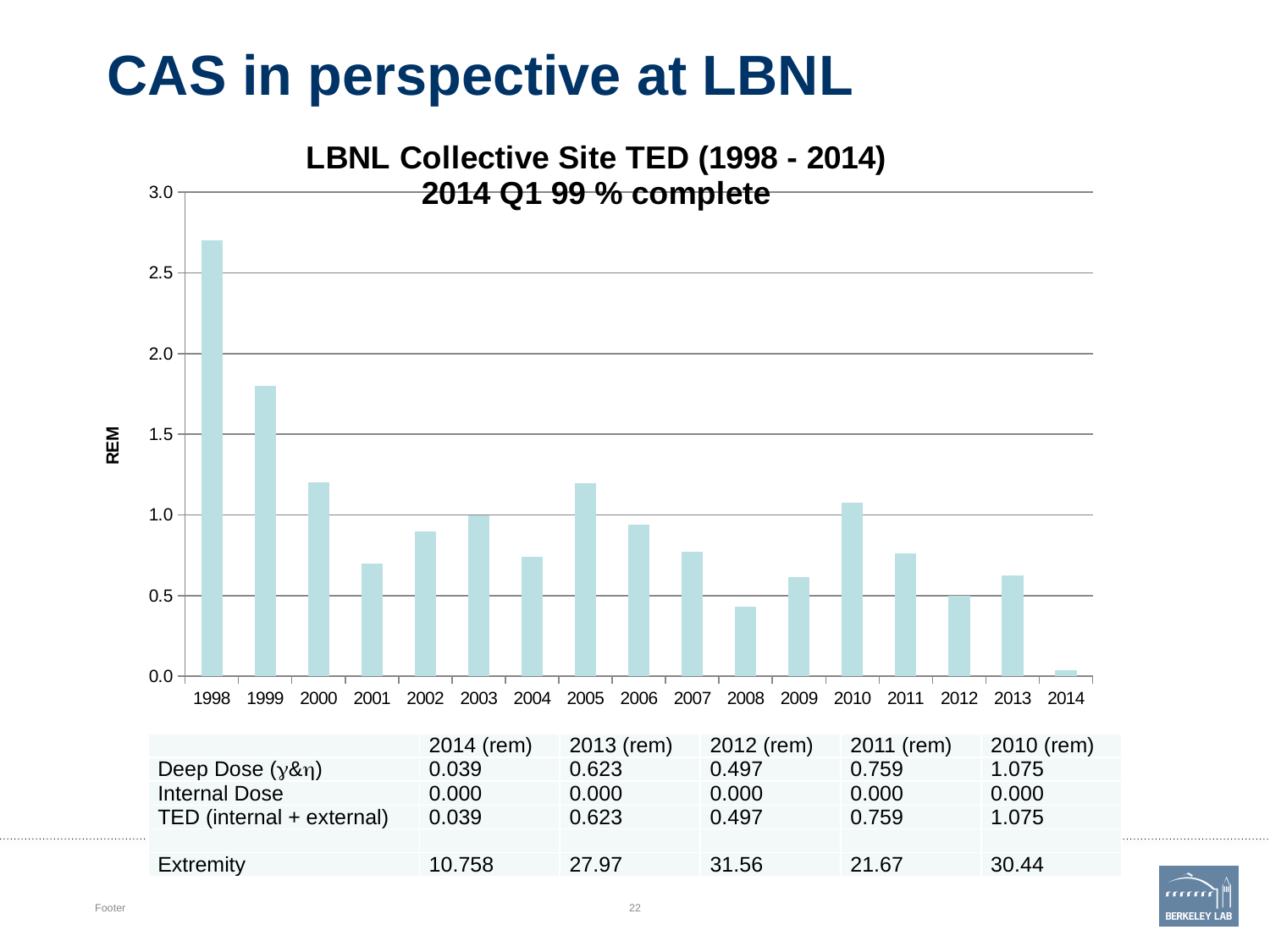
Is the value for 1999 greater or less than 1.5? greater Is the value for 1998 greater or less than 2.5? greater Is the value for 2008 greater or less than 0.5? less Which year has the highest collective site TED in the chart? 1998 Which year has the larger value, 1998 or 1999? 1998 How many years are plotted along the x axis of the chart? 17 What is the label on the y axis of the chart? REM What kind of chart is shown on the slide? bar chart Overall, do the values rise or fall from 1998 to 2014? fall Which year has the lowest collective site TED in the chart? 2014